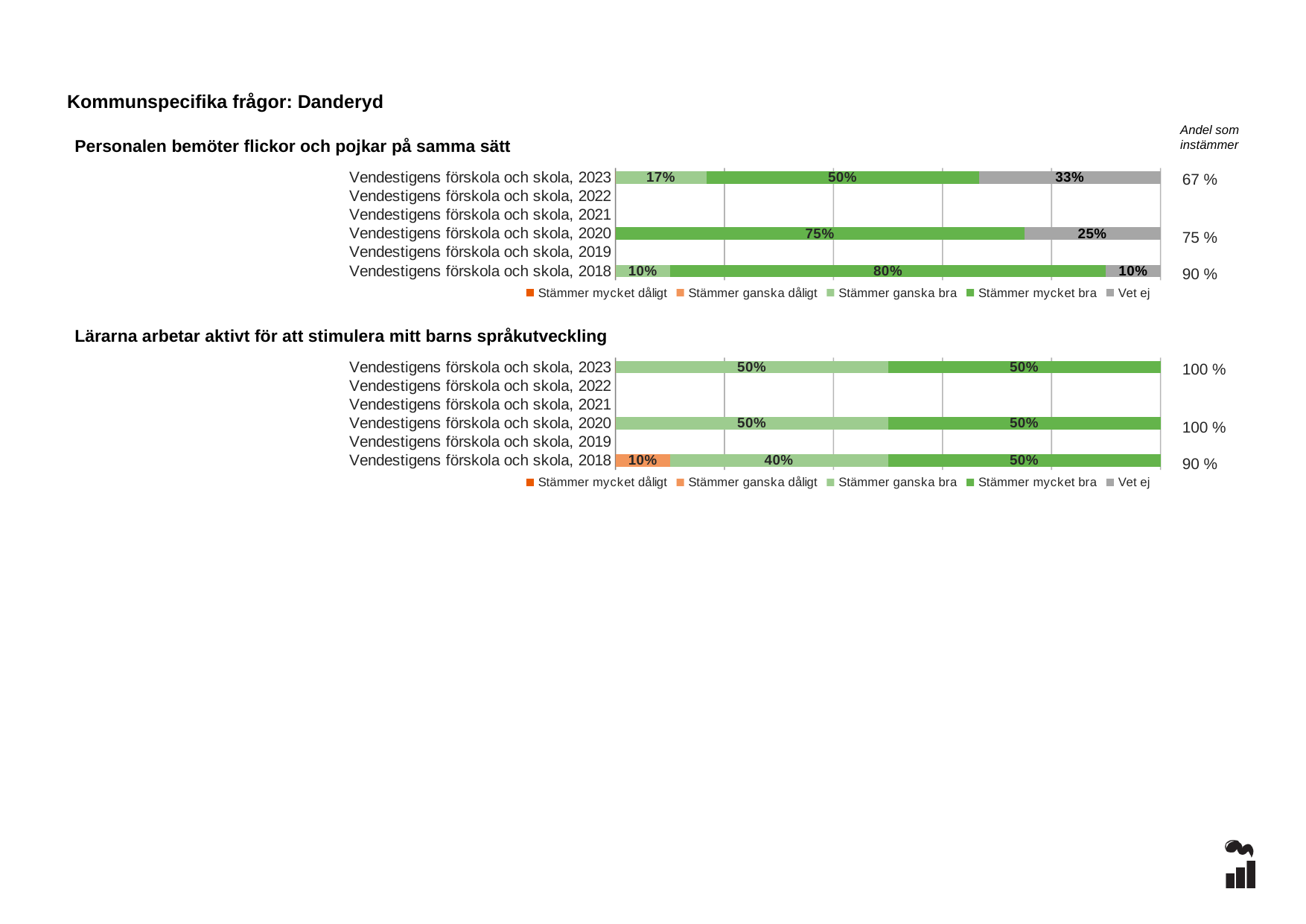
What kind of chart is 'Personalen bemöter flickor och pojkar på samma sätt'? Stacked bar chart In the chart 'Personalen bemöter flickor och pojkar på samma sätt', what is the 'Vet ej' value for Vendestigens förskola och skola, 2020? 25% In the chart 'Lärarna arbetar aktivt för att stimulera mitt barns språkutveckling', which is larger for 2018: 'Stämmer ganska bra' or 'Stämmer mycket bra'? Stämmer mycket bra How many series does the legend of the chart 'Personalen bemöter flickor och pojkar på samma sätt' list? 5 In the chart 'Personalen bemöter flickor och pojkar på samma sätt', which year has the highest 'Stämmer mycket bra' value? 2018 In the chart 'Lärarna arbetar aktivt för att stimulera mitt barns språkutveckling', what is the 'Stämmer ganska dåligt' value for Vendestigens förskola och skola, 2018? 10% In the chart 'Lärarna arbetar aktivt för att stimulera mitt barns språkutveckling', what is the total of the 2018 bar? 100% In the chart 'Personalen bemöter flickor och pojkar på samma sätt', what is the difference between the 'Vet ej' values for 2023 and 2018? 23% In the chart 'Personalen bemöter flickor och pojkar på samma sätt', what is the 'Stämmer mycket bra' value for Vendestigens förskola och skola, 2023? 50% In the chart 'Lärarna arbetar aktivt för att stimulera mitt barns språkutveckling', what is the 'Andel som instämmer' for Vendestigens förskola och skola, 2023? 100 % How many category rows are listed on the y axis of the chart 'Lärarna arbetar aktivt för att stimulera mitt barns språkutveckling'? 6 In the chart 'Personalen bemöter flickor och pojkar på samma sätt', what is the 'Andel som instämmer' for Vendestigens förskola och skola, 2018? 90 %